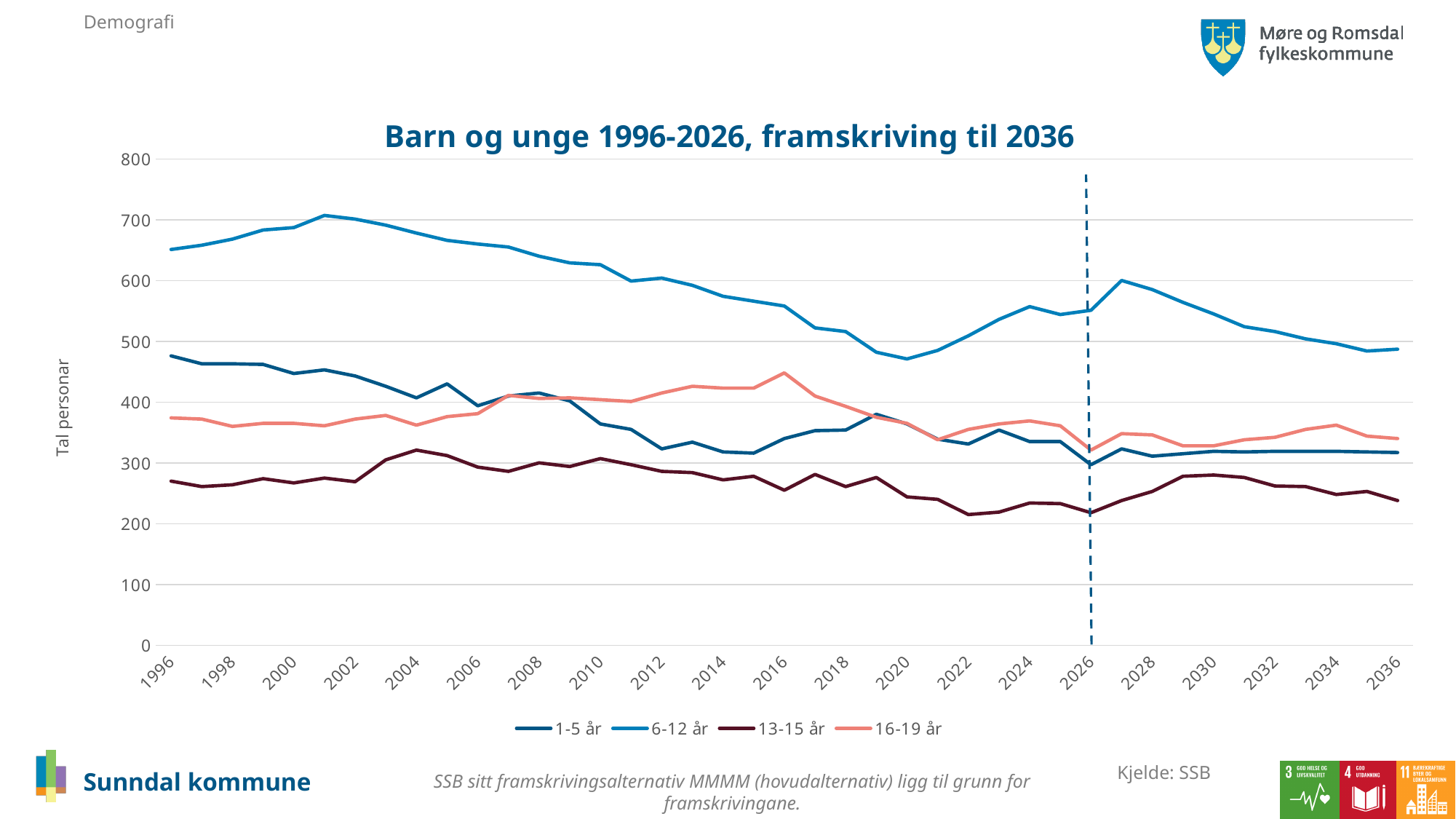
How many series does the legend list? 4 Which series has the lowest value in 2036? 13-15 år In 1996, which series has the higher value, 1-5 år or 16-19 år? 1-5 år Is the value for 16-19 år in 2016 greater or less than 400? greater What is the title of the chart? Barn og unge 1996-2026, framskriving til 2036 Is the value for 1-5 år in 2026 greater or less than 400? less Is the value for 6-12 år in 2002 greater or less than 600? greater Does the 6-12 år series rise or fall between 2002 and 2020? fall What is the label on the vertical axis? Tal personar What kind of chart is shown on the slide? line chart Which series has the highest value in 2036? 6-12 år